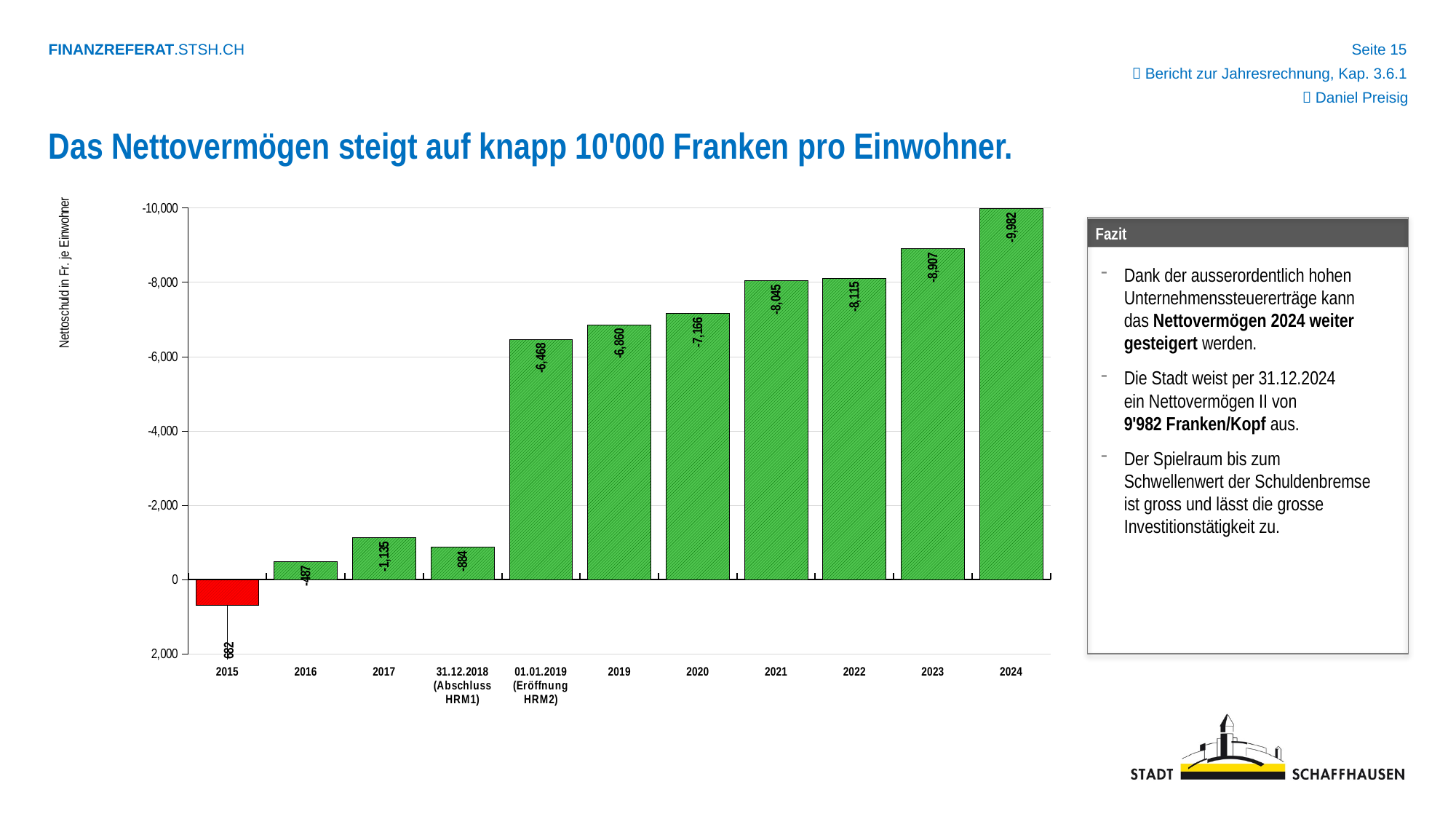
Which category has the highest value? 2015 What is the difference between the values for 2021 and 2022? 70 Which category has the lowest (most negative) value? 2024 What is the label of the vertical axis? Nettoschuld in Fr. je Einwohner What is the value for 01.01.2019 (Eröffnung HRM2)? -6,468 What kind of chart is shown on the slide? Bar chart What is the value for 2015? 682 What is the value for 2021? -8,045 How many categories are shown on the x axis? 11 What is the difference between the values for 2023 and 2024? 1,075 What is the value for 31.12.2018 (Abschluss HRM1)? -884 What is the value for 2024? -9,982